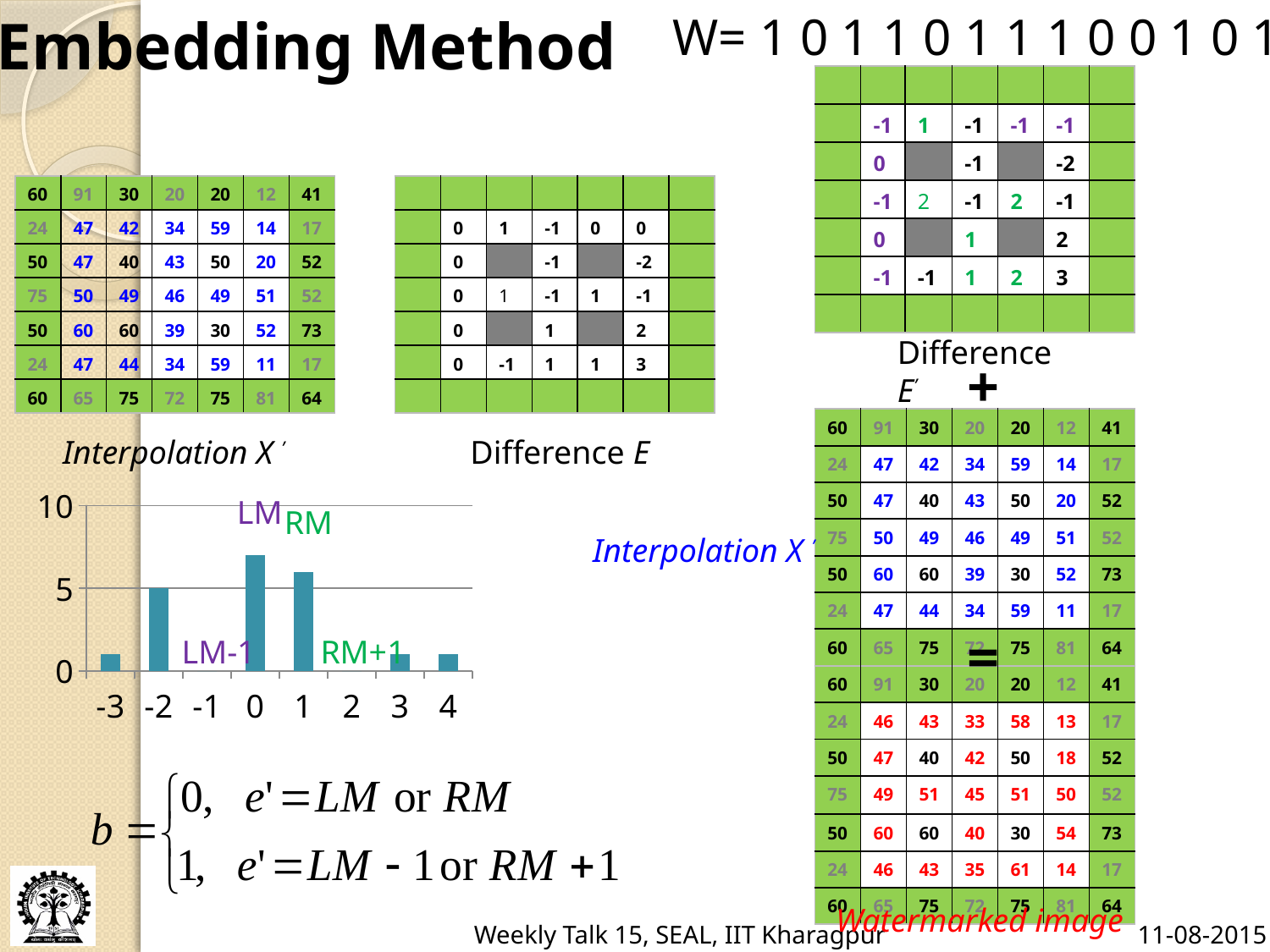
Which x-axis category is labelled LM in the chart? 0 How many categories are shown on the x axis of the chart? 8 Which has the larger value in the chart, category 0 or category 1? 0 Is the value for category 4 greater or less than 5? less Which x-axis category is labelled RM in the chart? 1 Which x-axis category has the tallest bar in the chart? 0 Is the value for category 0 greater or less than 5? greater What value does the bar for category -2 reach on the y axis? 5 Is the value for category -3 greater or less than 5? less What kind of chart is shown on the slide? bar chart Which has the larger value in the chart, category -2 or category 3? -2